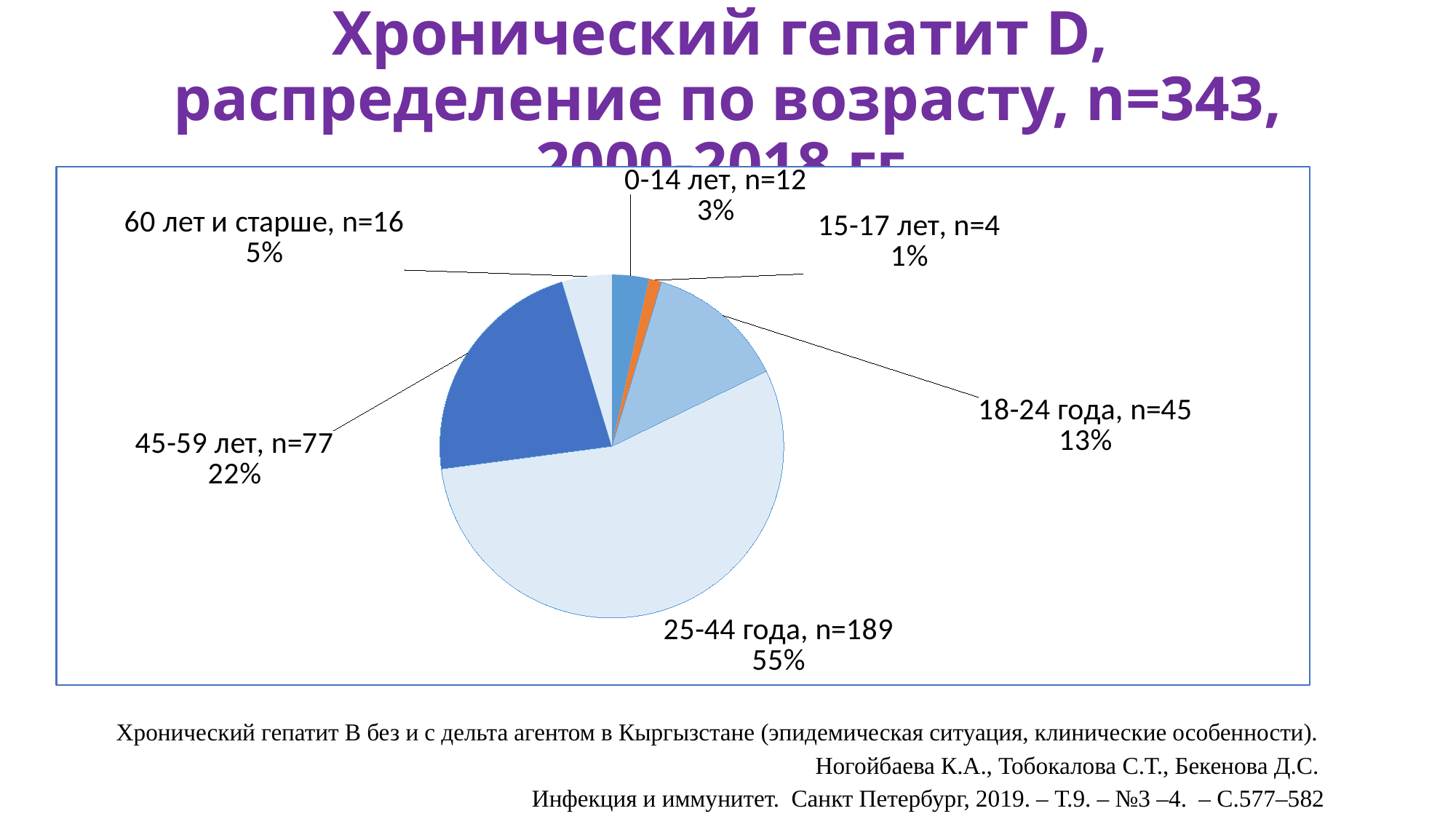
What total sample size (n) is stated in the slide title? 343 Which group has more cases: 18-24 года or 60 лет и старше? 18-24 года What percentage share does the 45-59 лет age group have? 22% How many age groups (slices) does the pie chart show? 6 What is the combined number of cases for the 0-14 лет and 15-17 лет groups? 16 What percentage share does the 0-14 лет age group have? 3% Which age group has the smallest share of the pie? 15-17 лет What is the difference in the number of cases between the 25-44 года and 45-59 лет groups? 112 Which age group has the largest share of the pie? 25-44 года What kind of chart is shown on the slide? pie chart What is the number of cases (n) for the 60 лет и старше age group? 16 What is the number of cases (n) for the 25-44 года age group? 189